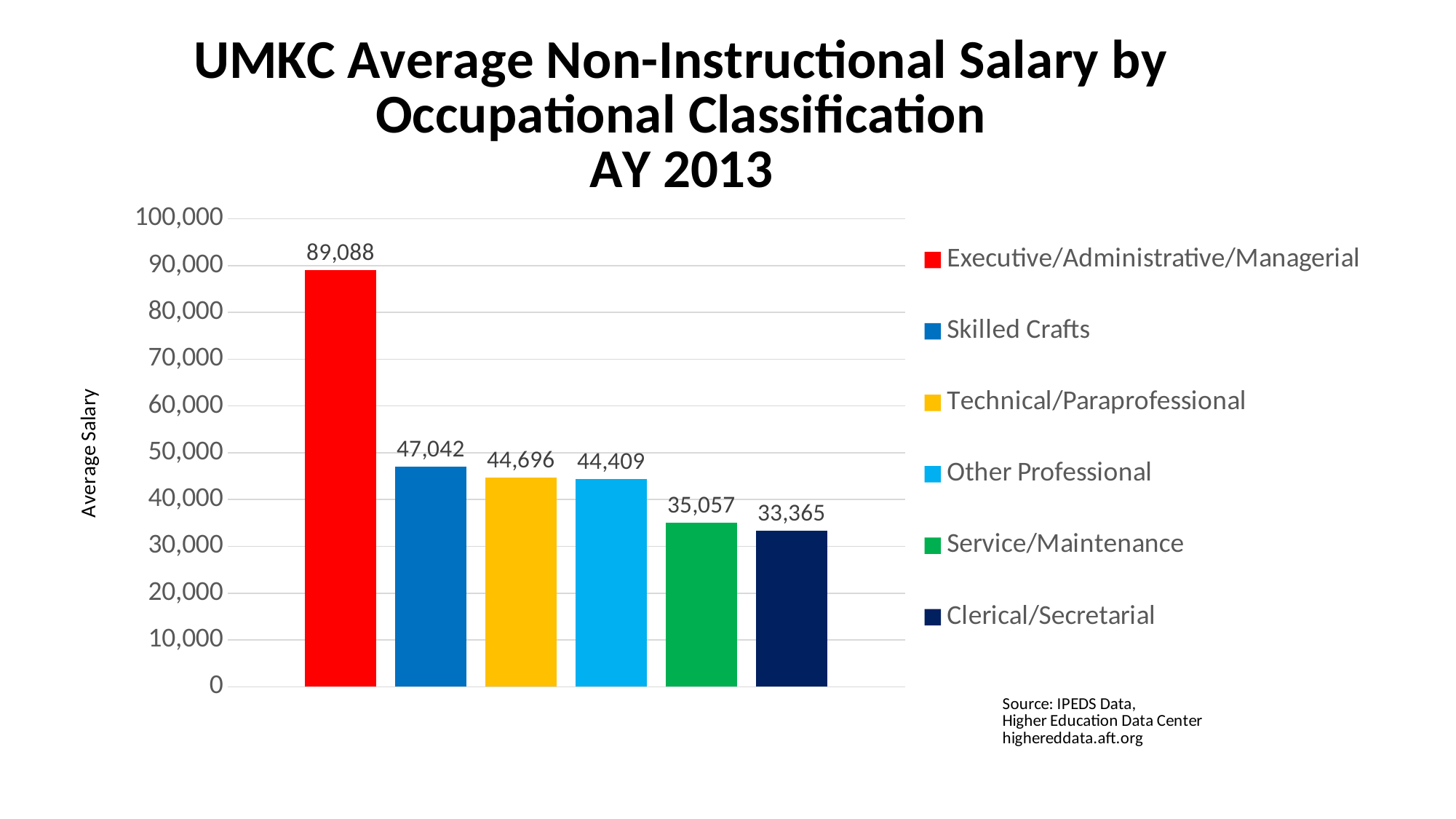
Which occupational classification has the lowest average salary? Clerical/Secretarial What is the difference between the average salary for Service/Maintenance and Clerical/Secretarial? 1,692 What colour is the bar for Technical/Paraprofessional? Yellow What is the average salary for Executive/Administrative/Managerial? 89,088 What kind of chart is shown on the slide? Bar chart What is the average salary for Clerical/Secretarial? 33,365 Which has a higher average salary, Technical/Paraprofessional or Service/Maintenance? Technical/Paraprofessional What is the difference between the average salary for Executive/Administrative/Managerial and Skilled Crafts? 42,046 How many occupational classifications are shown in the chart? 6 What is the average salary for Skilled Crafts? 47,042 Is the value for Other Professional greater or less than 40,000? greater Which occupational classification has the highest average salary? Executive/Administrative/Managerial